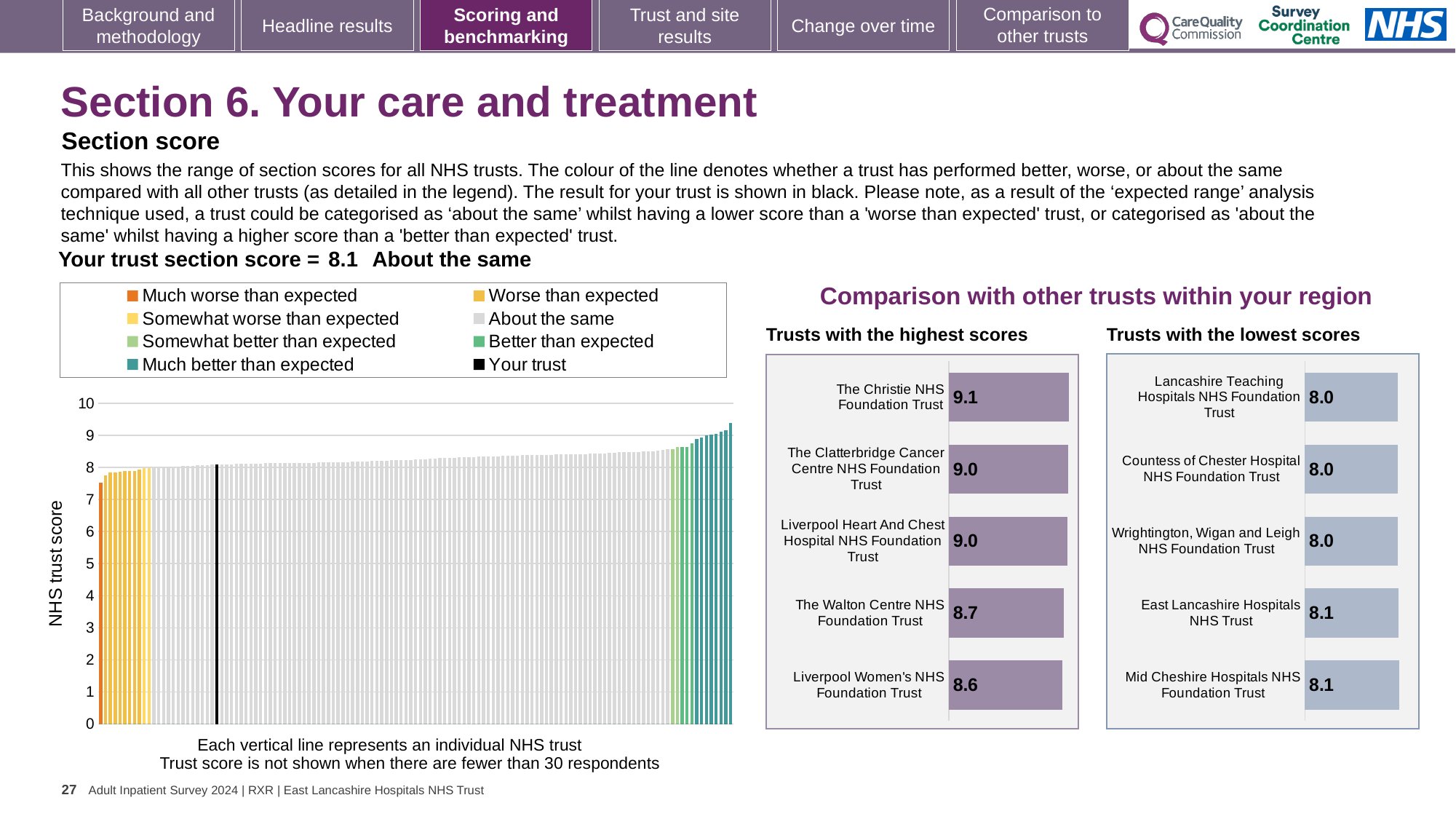
In the main chart of all NHS trusts, what is the section score for your trust? 8.1 How many trusts are shown in the 'Trusts with the lowest scores' chart? 5 In the 'Trusts with the highest scores' chart, what is the score for The Walton Centre NHS Foundation Trust? 8.7 In the 'Trusts with the highest scores' chart, which trust has the highest score? The Christie NHS Foundation Trust What kind of chart is the 'Trusts with the lowest scores' chart? Bar chart In the 'Trusts with the highest scores' chart, which trust has the lowest score? Liverpool Women's NHS Foundation Trust In the 'Trusts with the highest scores' chart, what is the score for The Christie NHS Foundation Trust? 9.1 In the 'Trusts with the lowest scores' chart, what is the score for East Lancashire Hospitals NHS Trust? 8.1 In the 'Trusts with the highest scores' chart, what is the difference between the scores of The Christie NHS Foundation Trust and Liverpool Women's NHS Foundation Trust? 0.5 How many entries does the legend of the main chart of all NHS trusts list? 8 In the main chart of all NHS trusts, is the value of the tallest bar greater or less than 9? greater In the 'Trusts with the highest scores' chart, which has the larger score: The Walton Centre NHS Foundation Trust or Liverpool Women's NHS Foundation Trust? The Walton Centre NHS Foundation Trust